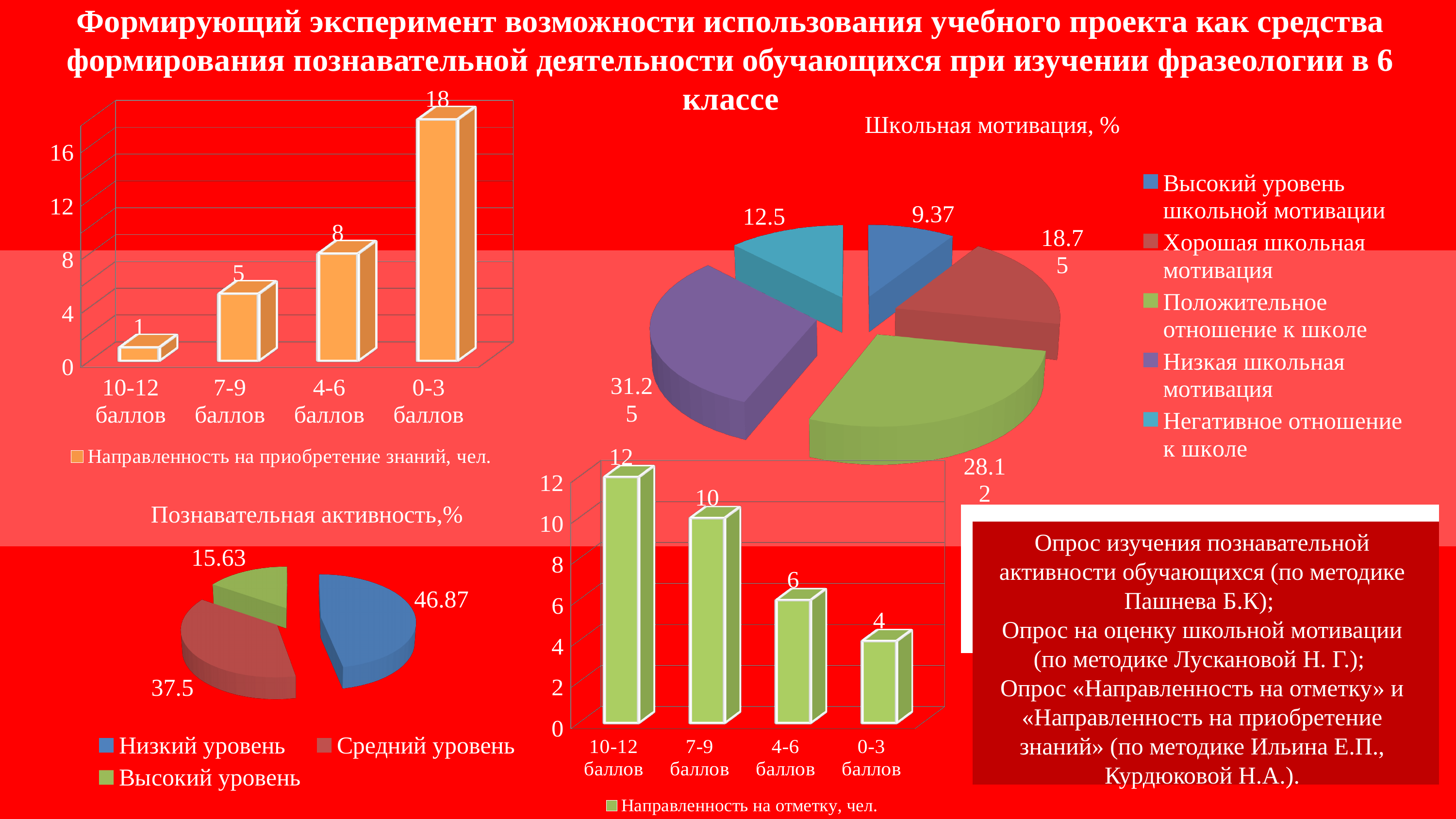
In the top-right pie chart (Школьная мотивация, %), what is the value for Высокий уровень школьной мотивации? 9.37 In the top-left bar chart (Направленность на приобретение знаний, чел.), which category has the lowest value? 10-12 баллов In the bottom-middle bar chart (Направленность на отметку, чел.), which is larger: the value for 4-6 баллов or the value for 0-3 баллов? 4-6 баллов In the top-left bar chart (Направленность на приобретение знаний, чел.), what is the difference between the values for 4-6 баллов and 7-9 баллов? 3 In the bottom-middle bar chart (Направленность на отметку, чел.), how many categories are shown on the x axis? 4 In the bottom-middle bar chart (Направленность на отметку, чел.), what is the value for 7-9 баллов? 10 How many entries does the legend of the top-right pie chart (Школьная мотивация, %) list? 5 In the bottom-left pie chart (Познавательная активность,%), what is the value for Низкий уровень? 46.87 In the top-left bar chart (Направленность на приобретение знаний, чел.), what is the value for 0-3 баллов? 18 In the top-left bar chart (Направленность на приобретение знаний, чел.), do the values rise or fall from left to right along the x axis? rise In the bottom-left pie chart (Познавательная активность,%), which level has the smallest slice? Высокий уровень In the bottom-middle bar chart (Направленность на отметку, чел.), which category has the highest value? 10-12 баллов